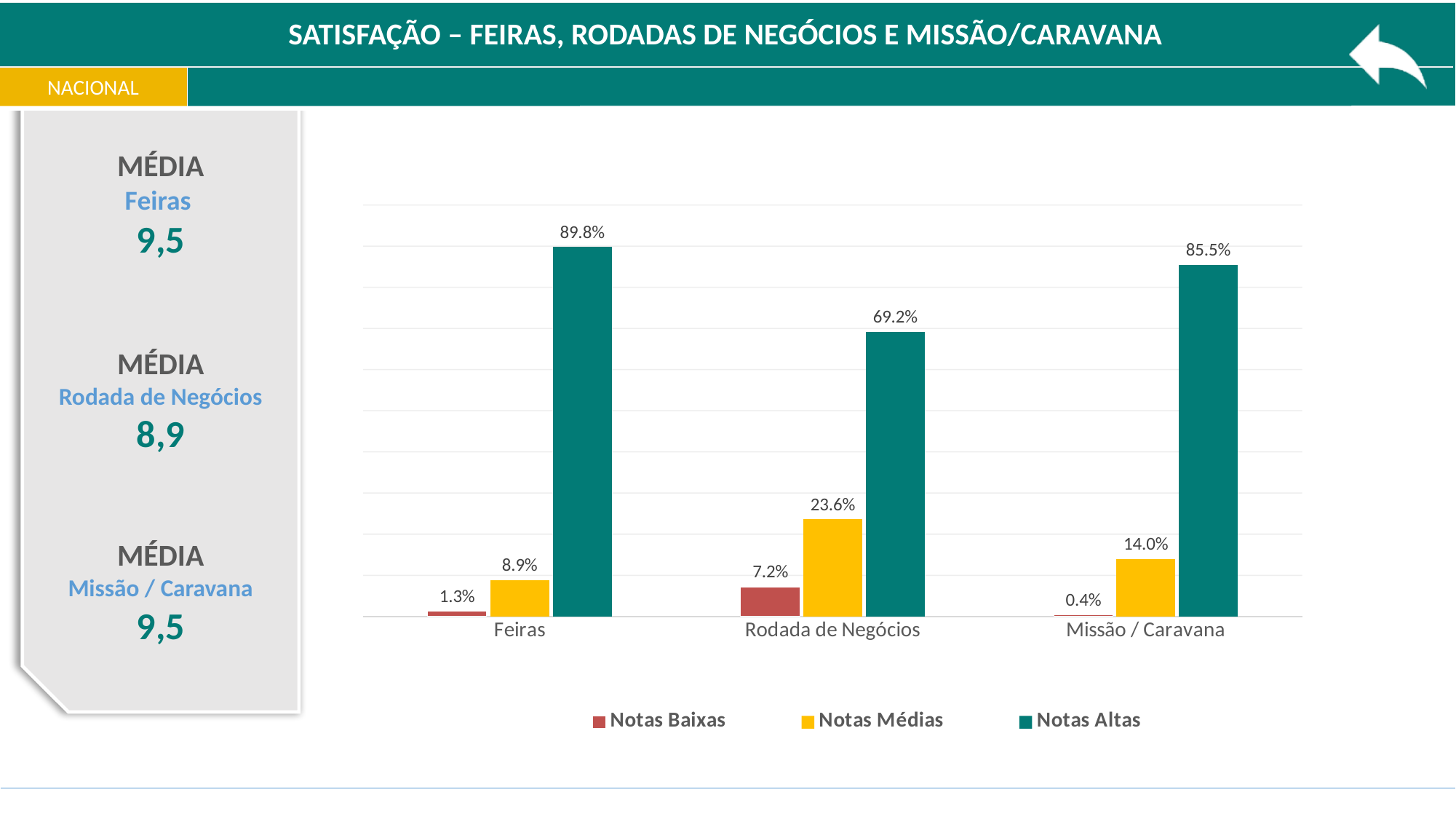
What is the difference between the Notas Altas values for Feiras and Rodada de Negócios? 20.6% Which category has the highest Notas Altas value? Feiras Which colour represents Notas Altas in the legend? Teal (green) What is the value of Notas Baixas for Missão / Caravana? 0.4% Which is larger: Notas Médias for Missão / Caravana or Notas Médias for Feiras? Notas Médias for Missão / Caravana What is the value of Notas Médias for Rodada de Negócios? 23.6% How many series does the legend list? 3 What kind of chart is shown on the slide? Bar chart What is the total of the three values for Rodada de Negócios? 100.0% Which category has the lowest Notas Baixas value? Missão / Caravana How many categories are shown on the x axis? 3 What is the value of Notas Altas for Feiras? 89.8%